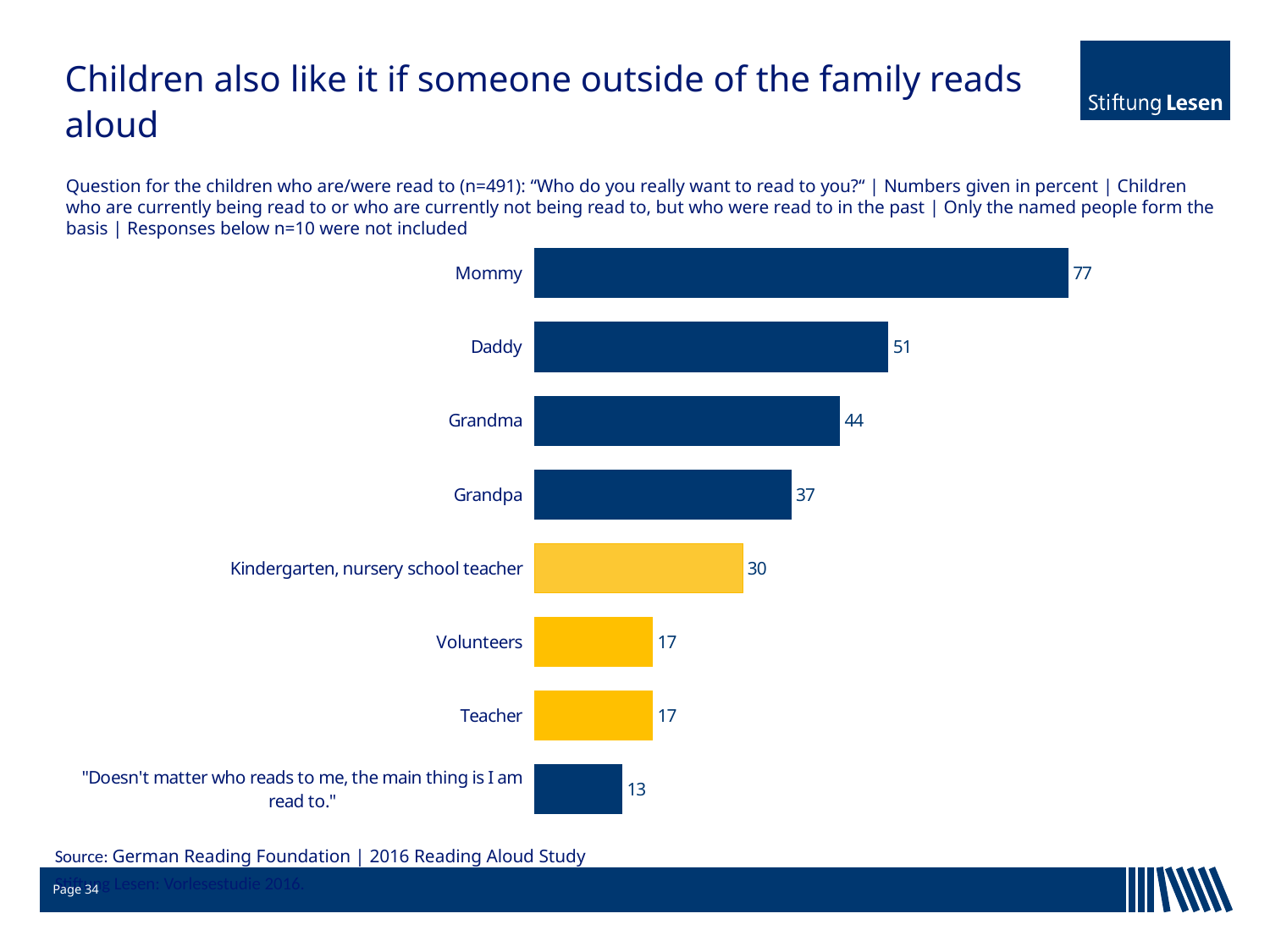
How many categories are shown in the chart? 8 Which category has the highest value? Mommy Which category has the lowest value? "Doesn't matter who reads to me, the main thing is I am read to." What is the difference between the values for Grandma and Grandpa? 7 What is the value for Kindergarten, nursery school teacher? 30 What is the value for Mommy? 77 Which categories have bars coloured yellow rather than dark blue? Kindergarten, nursery school teacher; Volunteers; Teacher What is the value for Grandma? 44 Which is larger, the value for Daddy or the value for Grandma? Daddy What is the value for Volunteers? 17 What is the difference between the values for Mommy and Daddy? 26 What kind of chart is shown on the slide? Bar chart